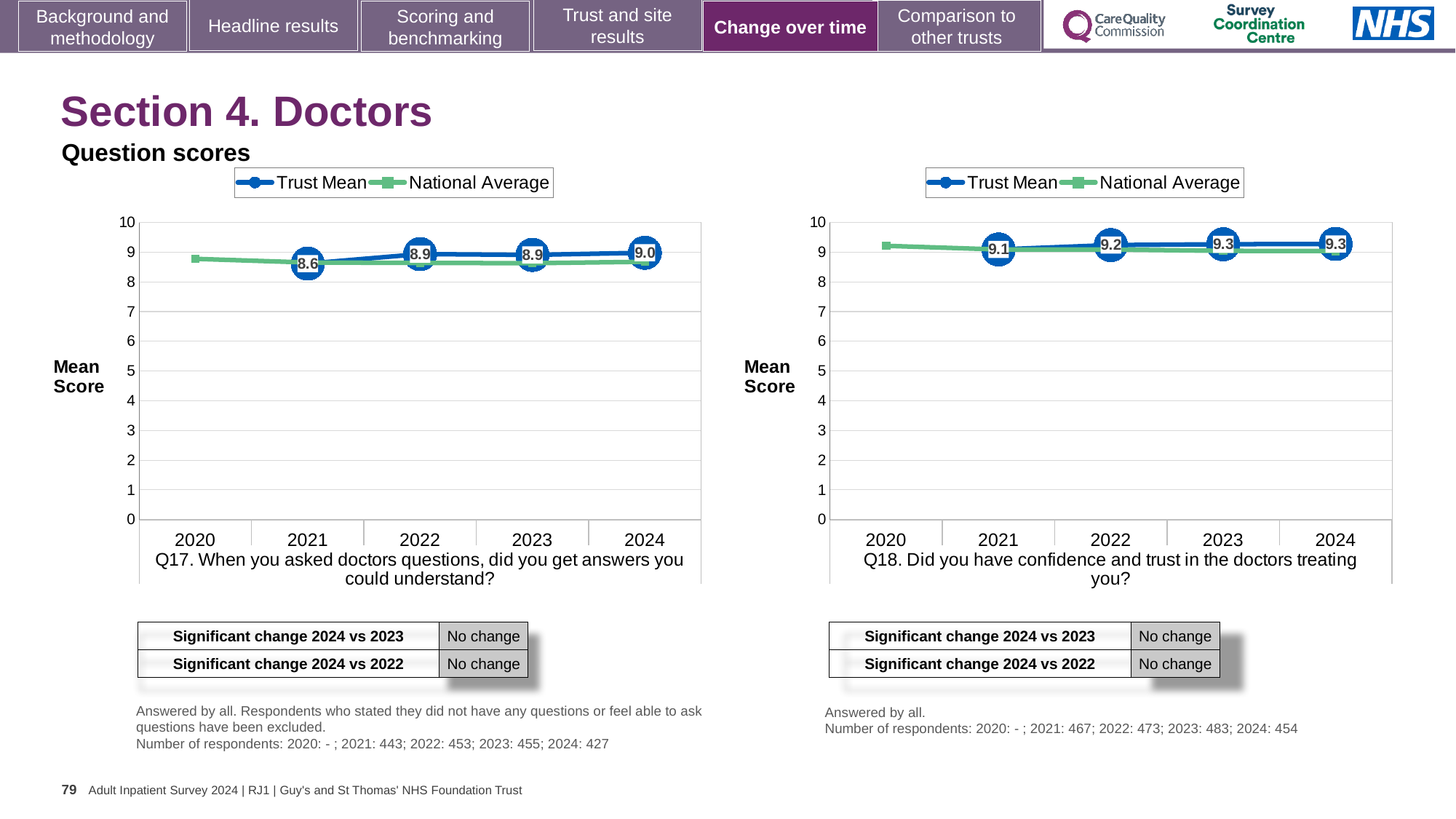
In the Q17 chart, which year has the lowest Trust Mean score? 2021 In the Q17 chart, what is the Trust Mean score for 2024? 9.0 In the Q18 chart, what is the Trust Mean score for 2022? 9.2 In the Q17 chart, is the National Average value for 2020 greater or less than 9? less In the Q17 chart, what is the difference between the Trust Mean scores for 2024 and 2021? 0.4 In the Q17 chart, which year has the highest Trust Mean score? 2024 In the Q18 chart, which year has the lowest Trust Mean score? 2021 What type of chart is used for Q17? Line chart In the Q18 chart, is the Trust Mean score for 2021 or 2023 higher? 2023 In the Q17 chart, what is the Trust Mean score for 2021? 8.6 In the Q18 chart, what is the Trust Mean score for 2024? 9.3 How many years are shown on the x axis of the Q18 chart? 5